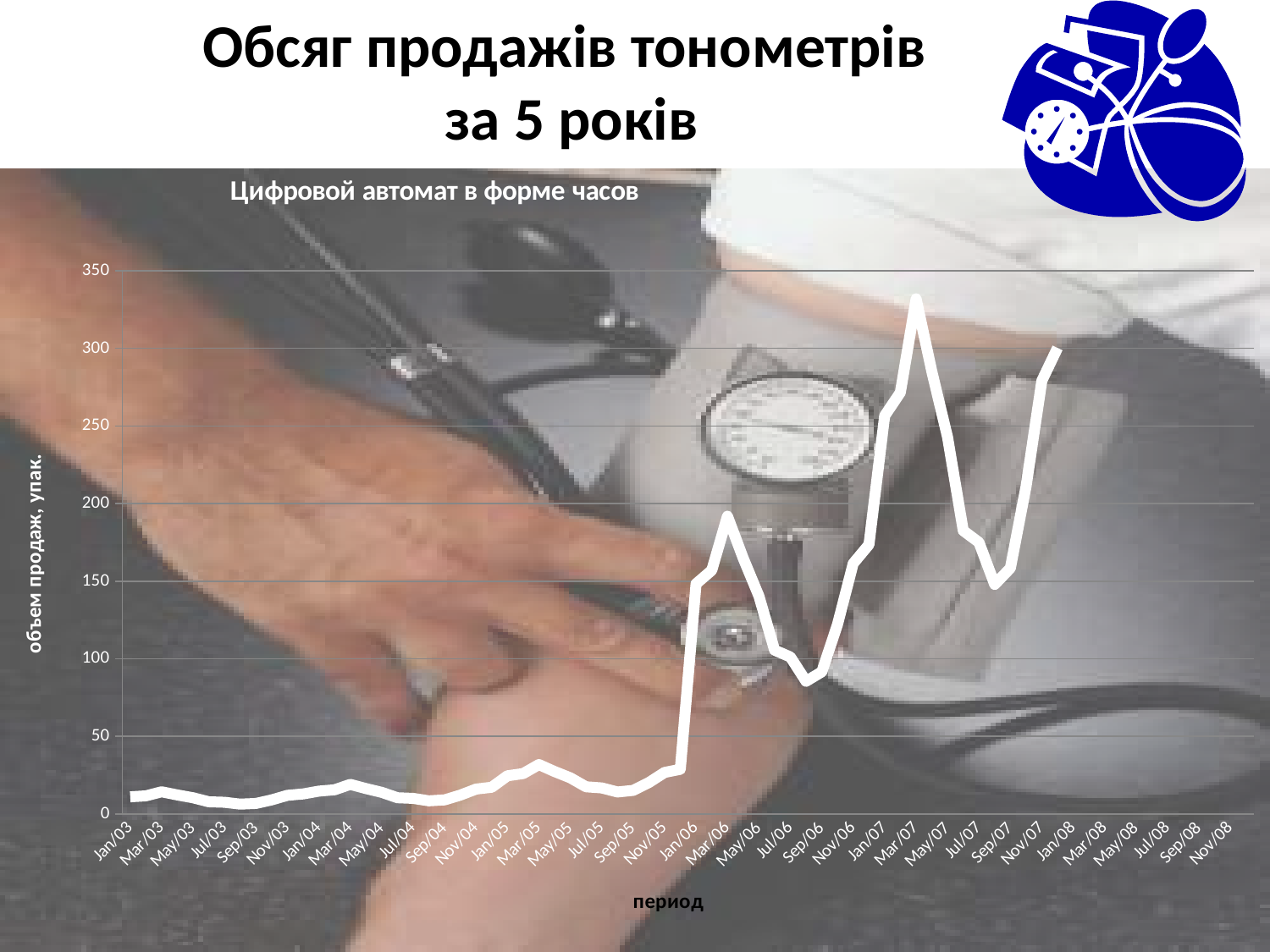
Is the value for Jan/03 greater or less than 50? less What is the title of the chart? Цифровой автомат в форме часов Is the value for Mar/07 greater or less than 300? greater Overall, do the values rise or fall from Jan/03 to Jan/08? rise In which period does the line reach its highest value? Mar/07 Is the value for Jan/07 greater or less than 200? greater What is the label of the vertical axis of the chart? объем продаж, упак. What kind of chart is shown on the slide? line chart